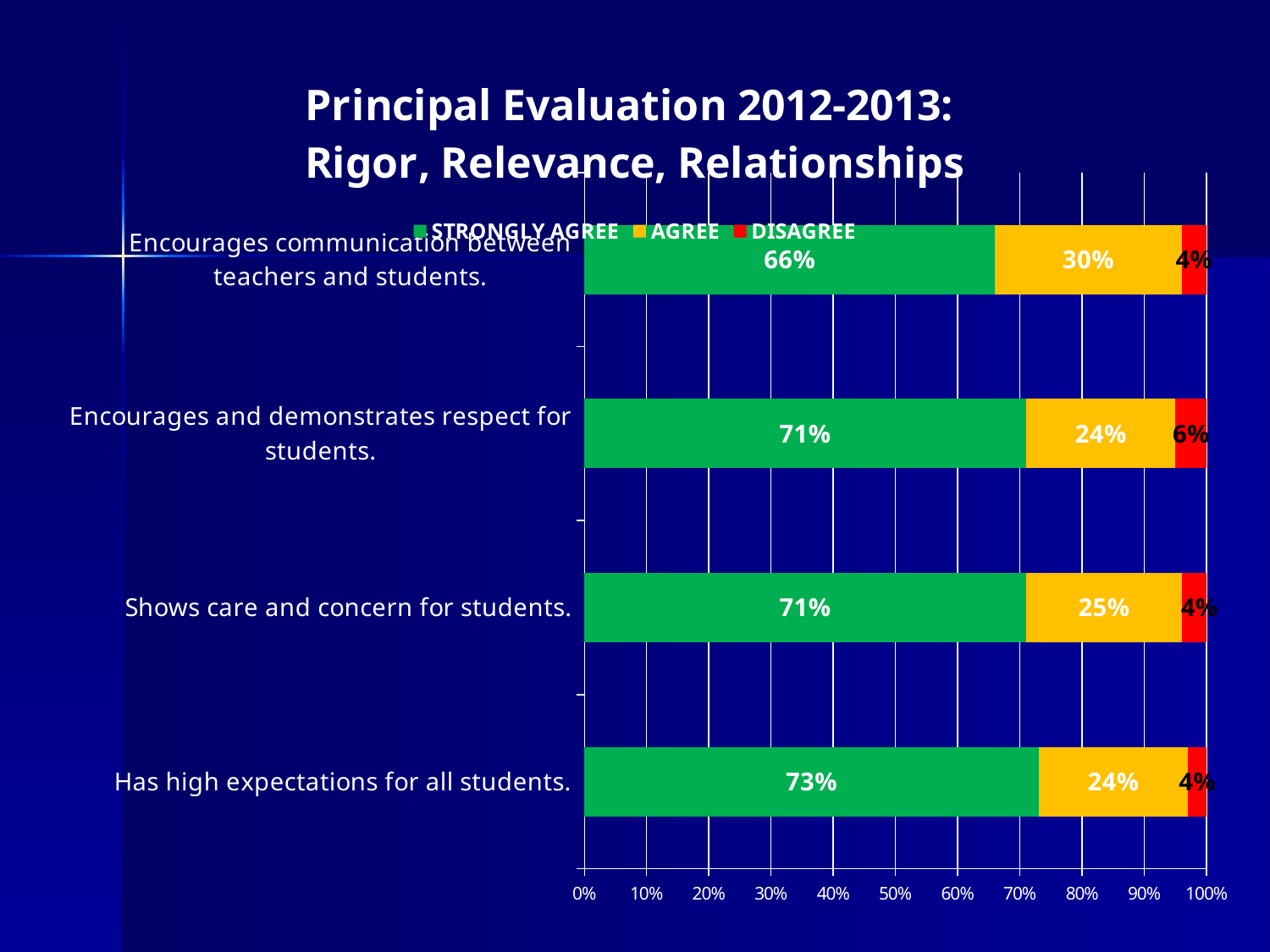
What is the difference between the STRONGLY AGREE values for "Has high expectations for all students." and "Encourages communication between teachers and students."? 7 percentage points Which category has the highest STRONGLY AGREE value? Has high expectations for all students. What is the AGREE value for "Encourages communication between teachers and students."? 30% What is the DISAGREE value for "Encourages and demonstrates respect for students."? 6% Which has the larger AGREE value: "Encourages communication between teachers and students." or "Shows care and concern for students."? Encourages communication between teachers and students. What is the STRONGLY AGREE value for "Has high expectations for all students."? 73% How many categories are shown in the chart? 4 How many series does the legend list? 3 Which category has the lowest STRONGLY AGREE value? Encourages communication between teachers and students. What is the title of the chart? Principal Evaluation 2012-2013: Rigor, Relevance, Relationships Which category has the highest DISAGREE value? Encourages and demonstrates respect for students. What kind of chart is shown on the slide? Stacked bar chart